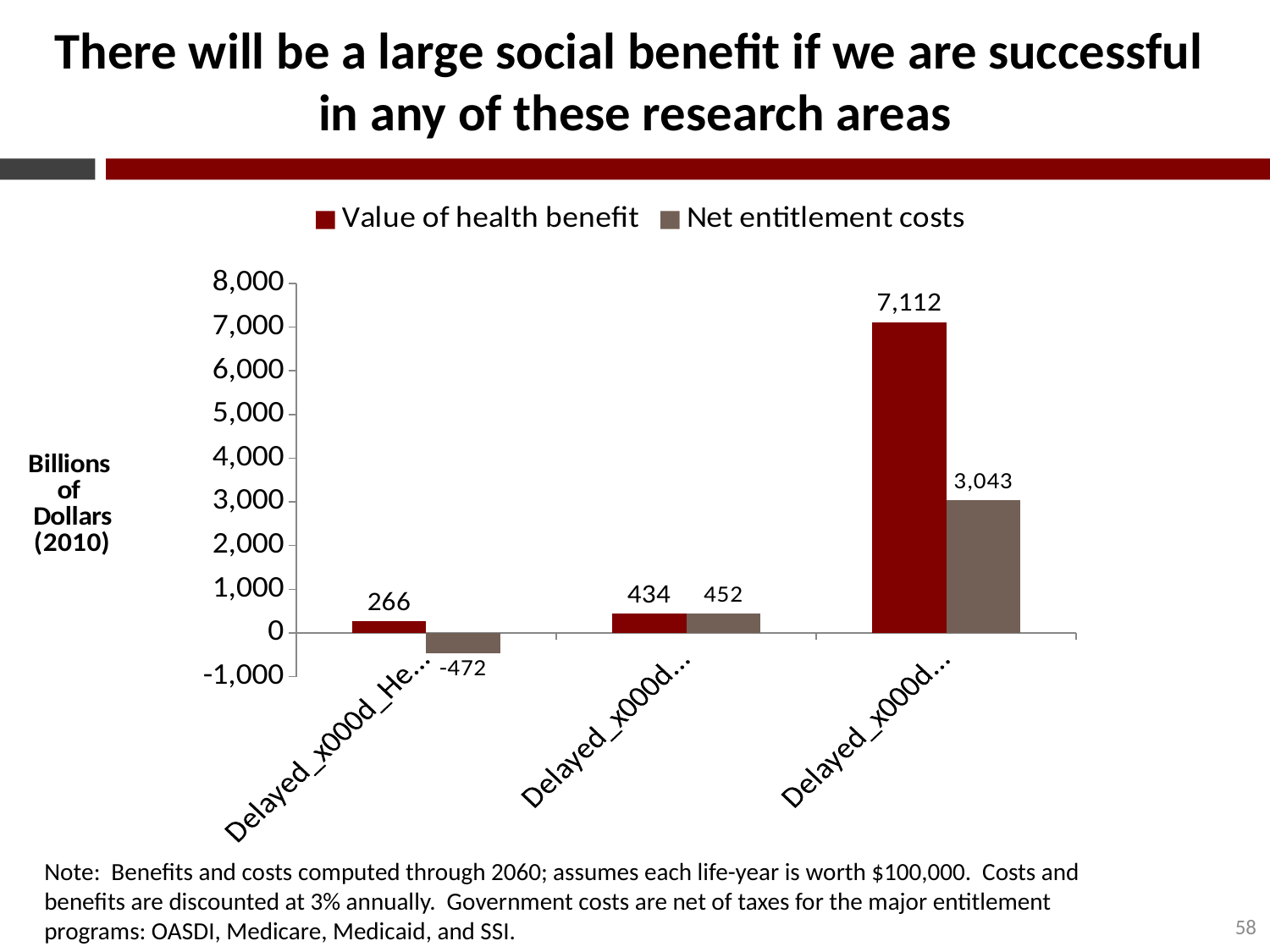
What kind of chart is shown on the slide? Bar chart What is the difference between the value of health benefit and the net entitlement cost for the rightmost category? 4,069 Which category has the lowest net entitlement cost? The leftmost category What unit is given on the vertical axis label? Billions of Dollars (2010) For the middle category, which is larger: the value of health benefit or the net entitlement cost? Net entitlement costs How many series does the legend list? 2 How many categories are shown on the x axis? 3 What is the value of health benefit for the rightmost category? 7,112 What is the net entitlement cost for the rightmost category? 3,043 Which category has the highest value of health benefit? The rightmost category What is the value of health benefit for the middle category? 434 What is the net entitlement cost for the leftmost category? -472